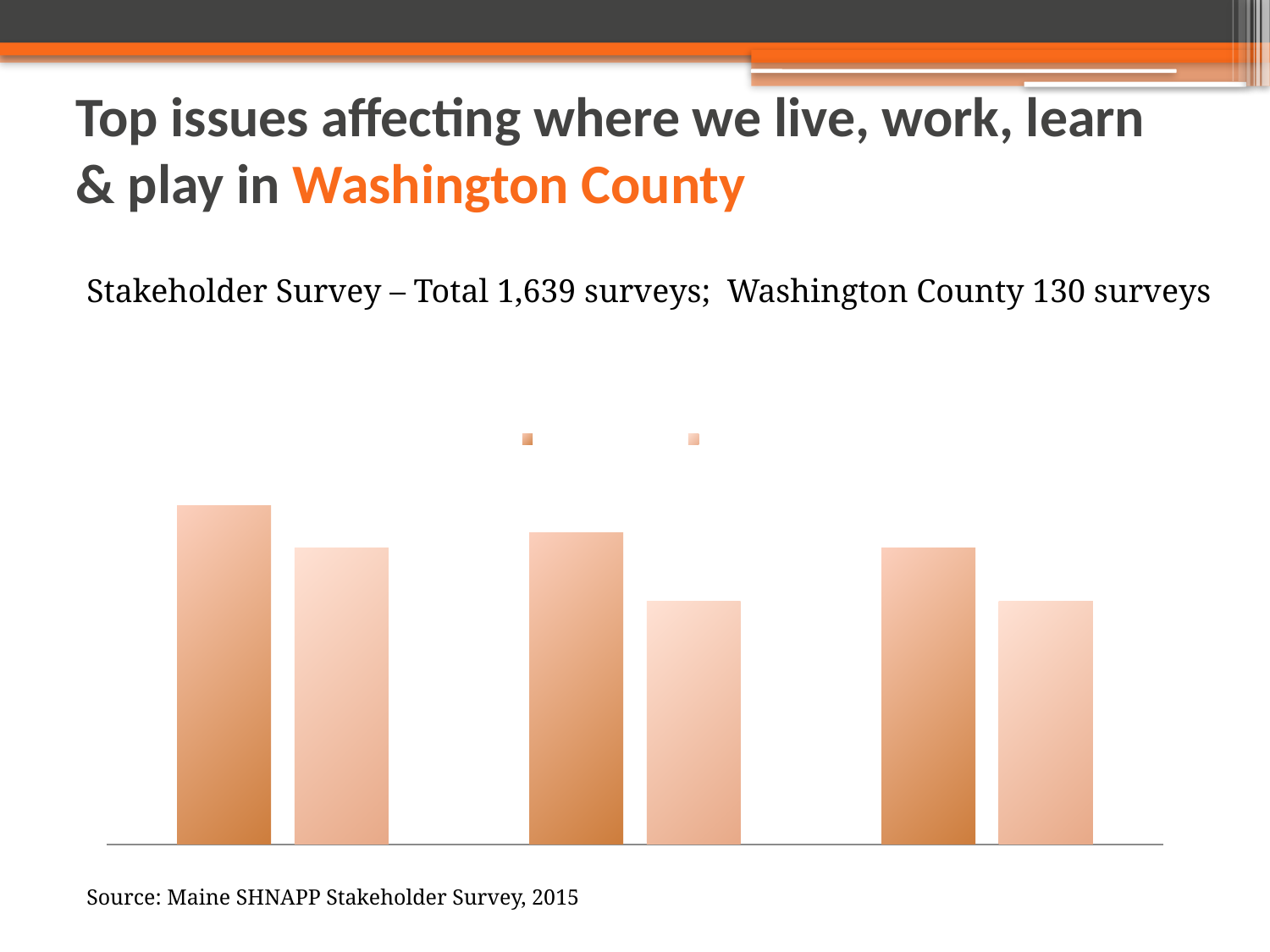
What source is cited below the chart? Maine SHNAPP Stakeholder Survey, 2015 How many series does the chart's legend list? 2 Do the darker bars rise or fall from left to right across the three groups? fall In the rightmost group of bars, is the darker (left) bar or the lighter (right) bar taller? the darker (left) bar In the middle group of bars, is the darker (left) bar or the lighter (right) bar taller? the darker (left) bar In the leftmost group of bars, is the darker (left) bar or the lighter (right) bar taller? the darker (left) bar What kind of chart is shown on the slide? bar chart According to the slide, how many surveys were collected in Washington County? 130 How many groups of bars (categories) does the chart show? 3 Which group of bars contains the tallest bar on the chart: the leftmost, middle, or rightmost? leftmost